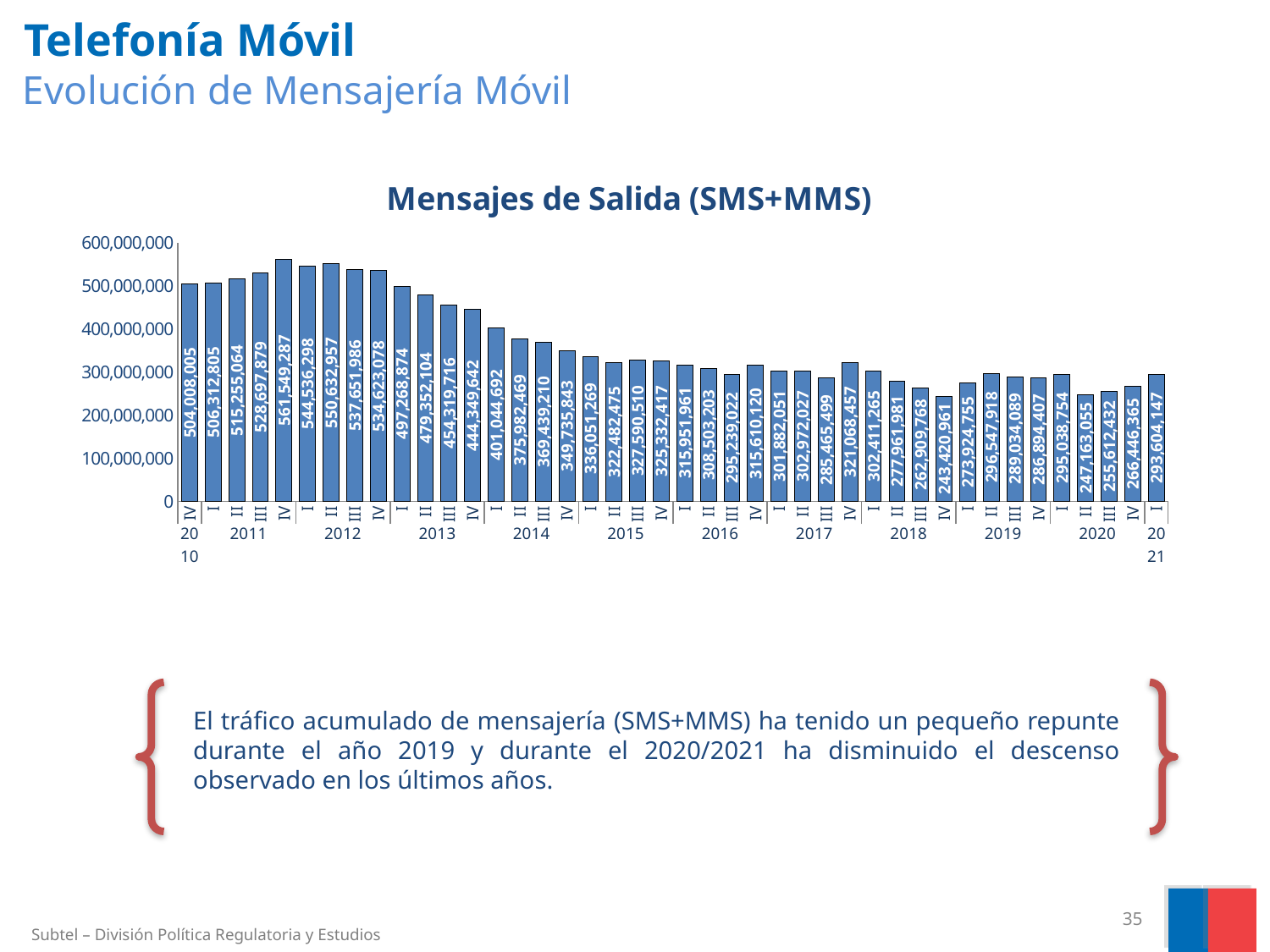
How many bars are plotted in the Mensajes de Salida (SMS+MMS) chart? 42 What is the value for quarter IV of 2010 in the Mensajes de Salida (SMS+MMS) chart? 504,008,005 Is the value for quarter IV of 2018 in the Mensajes de Salida (SMS+MMS) chart greater or less than 300,000,000? less Which quarter has the highest value in the Mensajes de Salida (SMS+MMS) chart? IV 2011 Which quarter has the lowest value in the Mensajes de Salida (SMS+MMS) chart? IV 2018 What is the value for quarter I of 2021 in the Mensajes de Salida (SMS+MMS) chart? 293,604,147 What is the value for quarter II of 2020 in the Mensajes de Salida (SMS+MMS) chart? 247,163,055 Do the values in the Mensajes de Salida (SMS+MMS) chart generally rise or fall from quarter IV of 2011 to quarter IV of 2018? fall Which is larger in the Mensajes de Salida (SMS+MMS) chart: the value for quarter I of 2014 or the value for quarter I of 2015? I 2014 What is the title of the chart on the slide? Mensajes de Salida (SMS+MMS) What kind of chart is the Mensajes de Salida (SMS+MMS) chart? bar chart What is the difference between the values for quarter I of 2021 and quarter IV of 2020 in the Mensajes de Salida (SMS+MMS) chart? 27,157,782